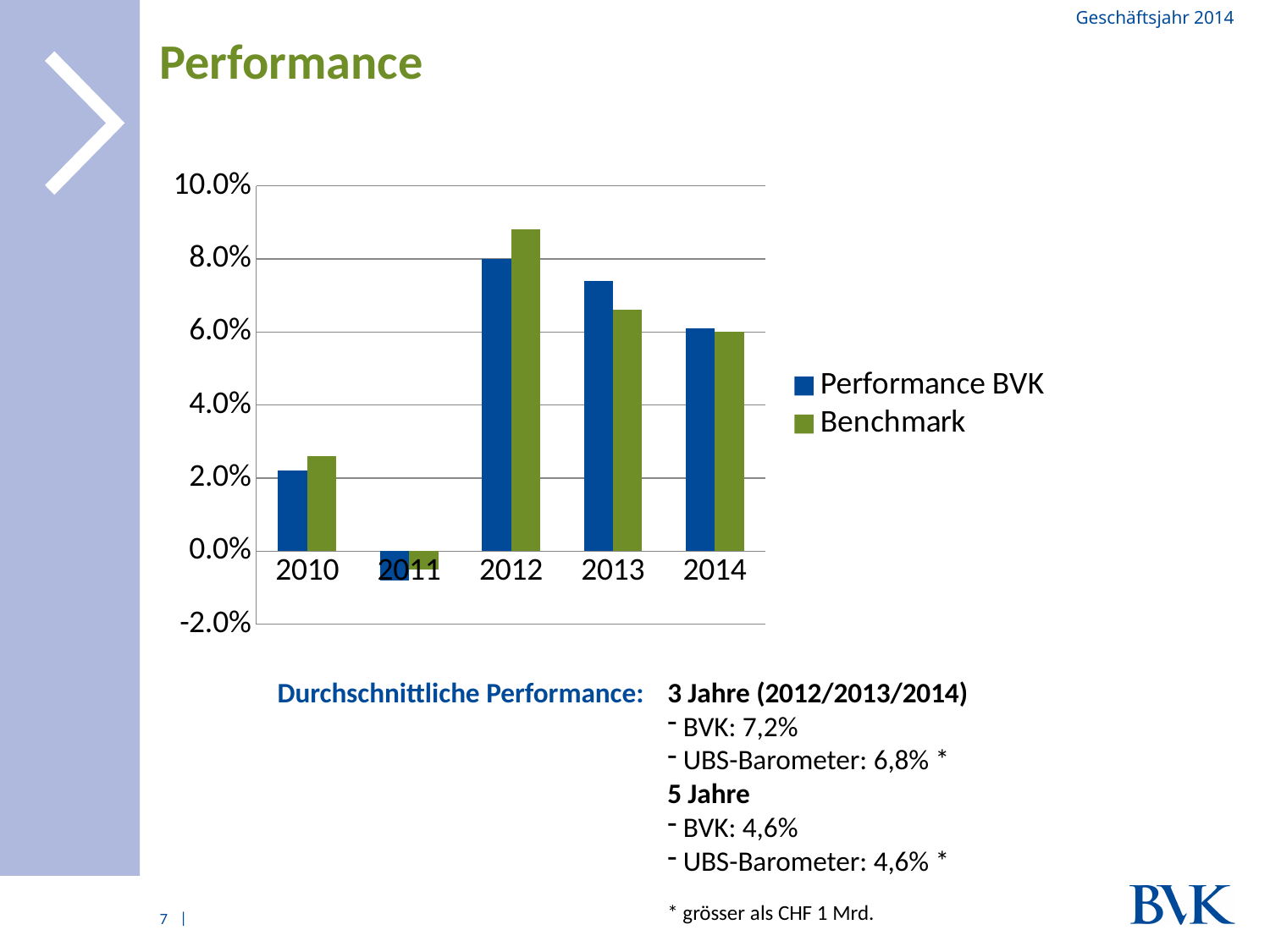
What kind of chart is shown on the slide? bar chart How many series does the legend list? 2 In 2013, which is larger: Performance BVK or Benchmark? Performance BVK In which year is the Benchmark bar the highest? 2012 How many years are shown on the x axis of the chart? 5 Is the Benchmark value for 2010 greater or less than 4.0%? less Is the Performance BVK value for 2013 greater or less than 6.0%? greater In which year is the Performance BVK bar the highest? 2012 In which year is the Performance BVK bar the lowest? 2011 What are the two entries in the chart legend? Performance BVK, Benchmark In 2010, which is larger: Performance BVK or Benchmark? Benchmark In 2012, which is larger: Performance BVK or Benchmark? Benchmark